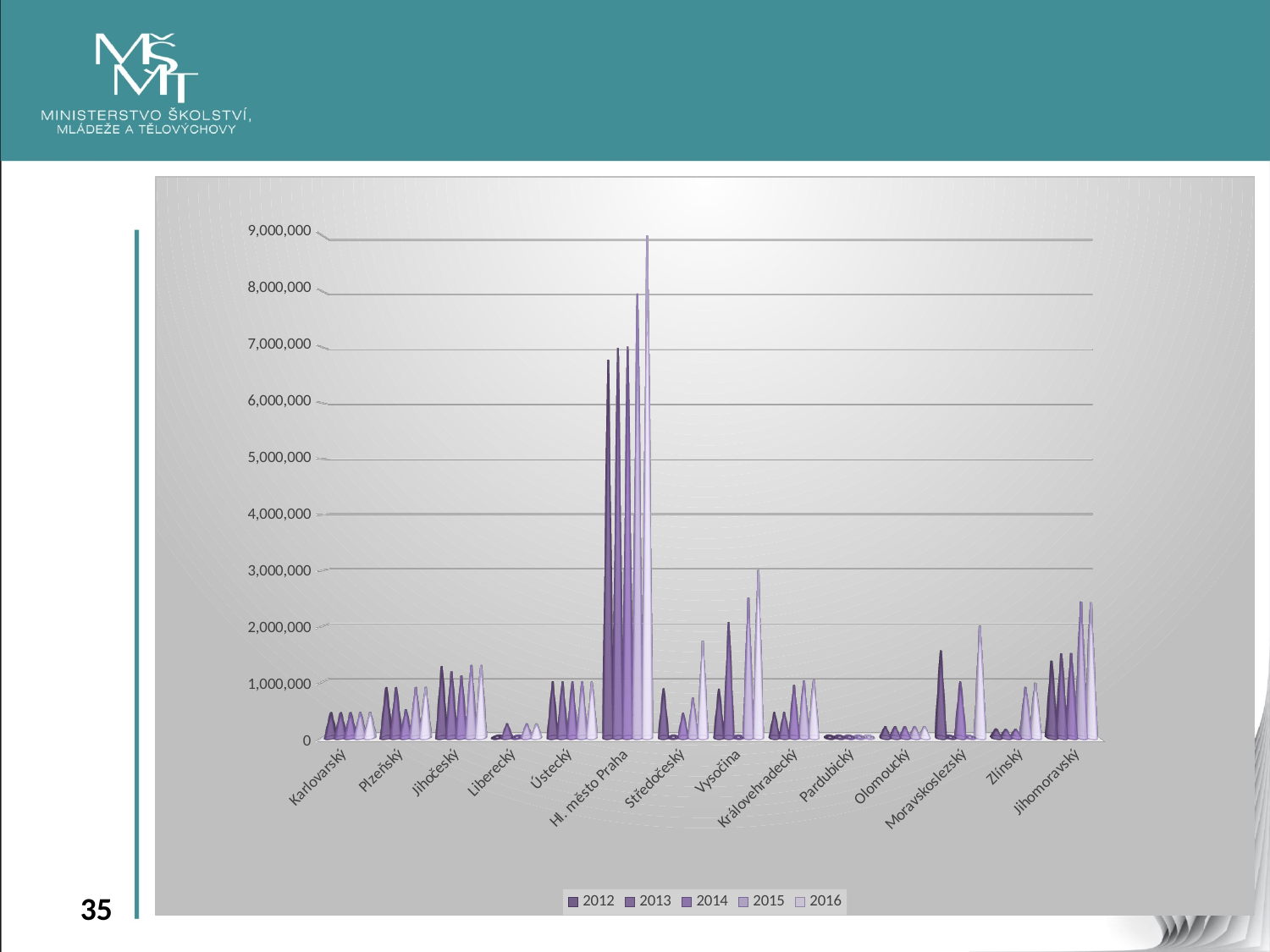
Which region has the lowest values in the chart? Pardubický Is the 2015 value for Jihomoravský greater or less than 2,000,000? greater Is the 2012 value for Hl. město Praha greater or less than 7,000,000? less Which region has the highest values in the chart? Hl. město Praha Is the 2012 value for Moravskoslezský greater or less than 1,000,000? greater What kind of chart is shown on the slide? bar chart Which is larger for 2016: the value for Hl. město Praha or the value for Středočeský? Hl. město Praha How many series does the chart's legend list? 5 Which years are listed in the chart's legend? 2012, 2013, 2014, 2015, 2016 Do the values for Hl. město Praha rise or fall from 2012 to 2016? rise How many regions (categories) are shown on the x axis of the chart? 14